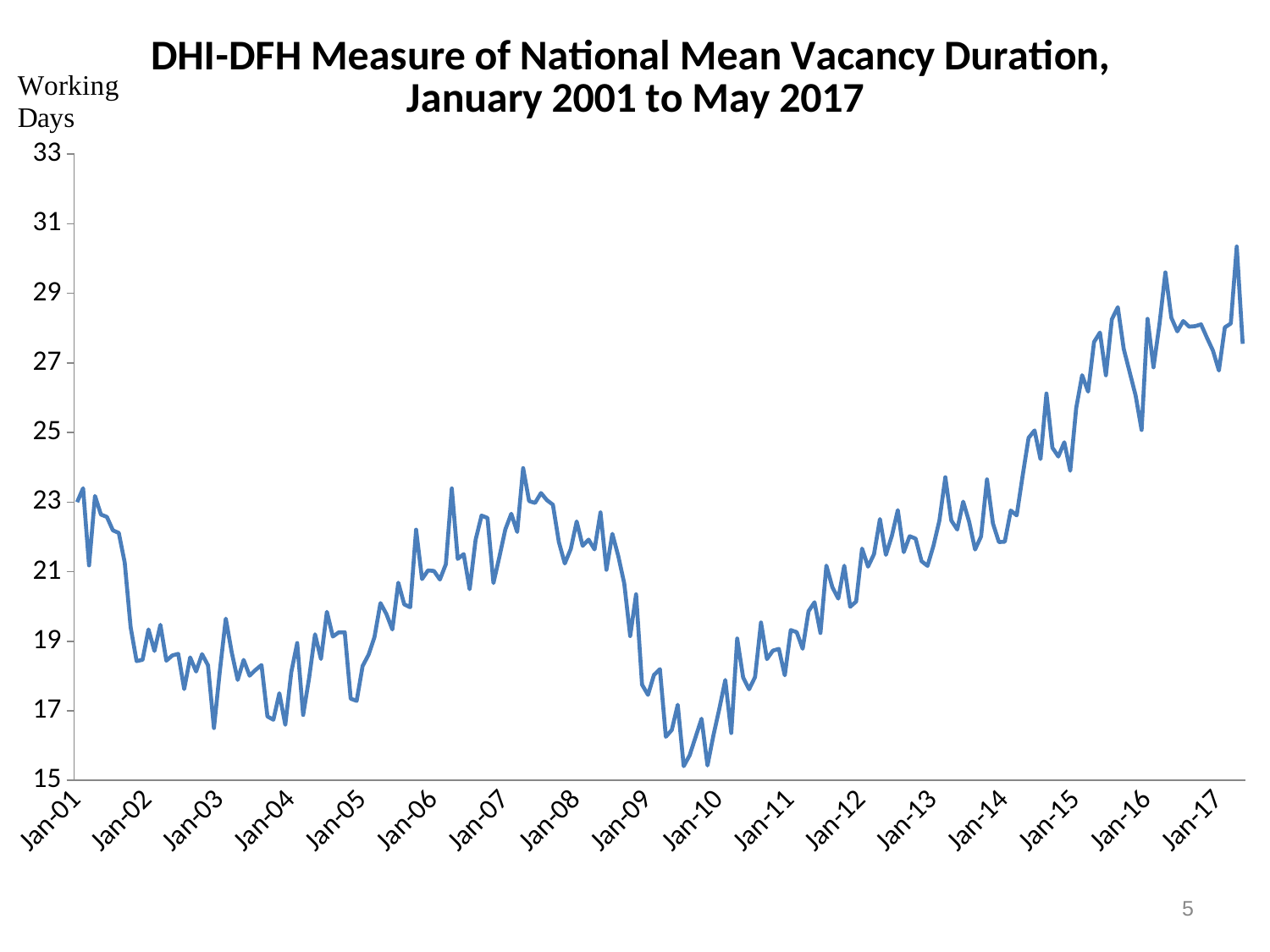
Which is larger, the value at Jan-17 or the value at Jan-01? Jan-17 Does the line generally rise or fall between Jan-08 and Jan-10? fall Does the line generally rise or fall between Jan-10 and Jan-17? rise Is the value at Jan-01 greater or less than 21? greater What kind of chart is shown on the slide? line chart How many tick labels are shown on the x axis? 17 What unit is the vertical axis labelled with? Working Days Is the value at Jan-17 greater or less than 25? greater What is the title of the chart? DHI-DFH Measure of National Mean Vacancy Duration, January 2001 to May 2017 How many series are plotted on the chart? 1 Is the value at Jan-03 greater or less than 21? less